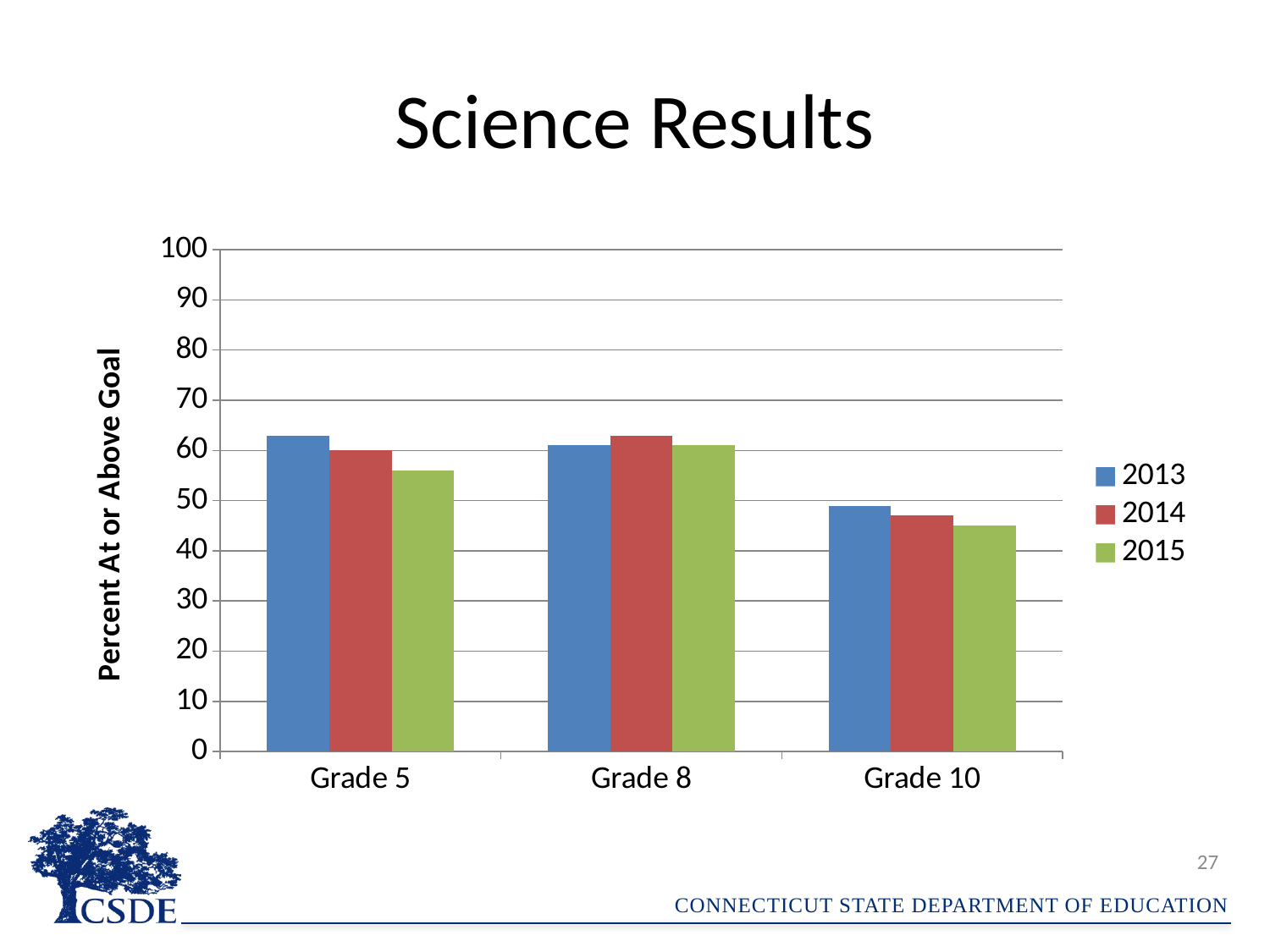
How many series does the legend list? 3 Which is larger, the 2013 value for Grade 5 or the 2013 value for Grade 10? Grade 5 For Grade 10, do the values rise or fall from 2013 to 2015? fall Is the 2014 value for Grade 8 greater or less than 60? greater How many grade categories are shown on the x axis? 3 For Grade 5, which year has the larger value, 2013 or 2015? 2013 What kind of chart is shown on the slide? bar chart What is the title of the chart's vertical axis? Percent At or Above Goal Which grade has the highest 2014 value? Grade 8 Which grade has the lowest 2015 value? Grade 10 Is the 2015 value for Grade 5 greater or less than 60? less Is the 2015 value for Grade 10 greater or less than 50? less